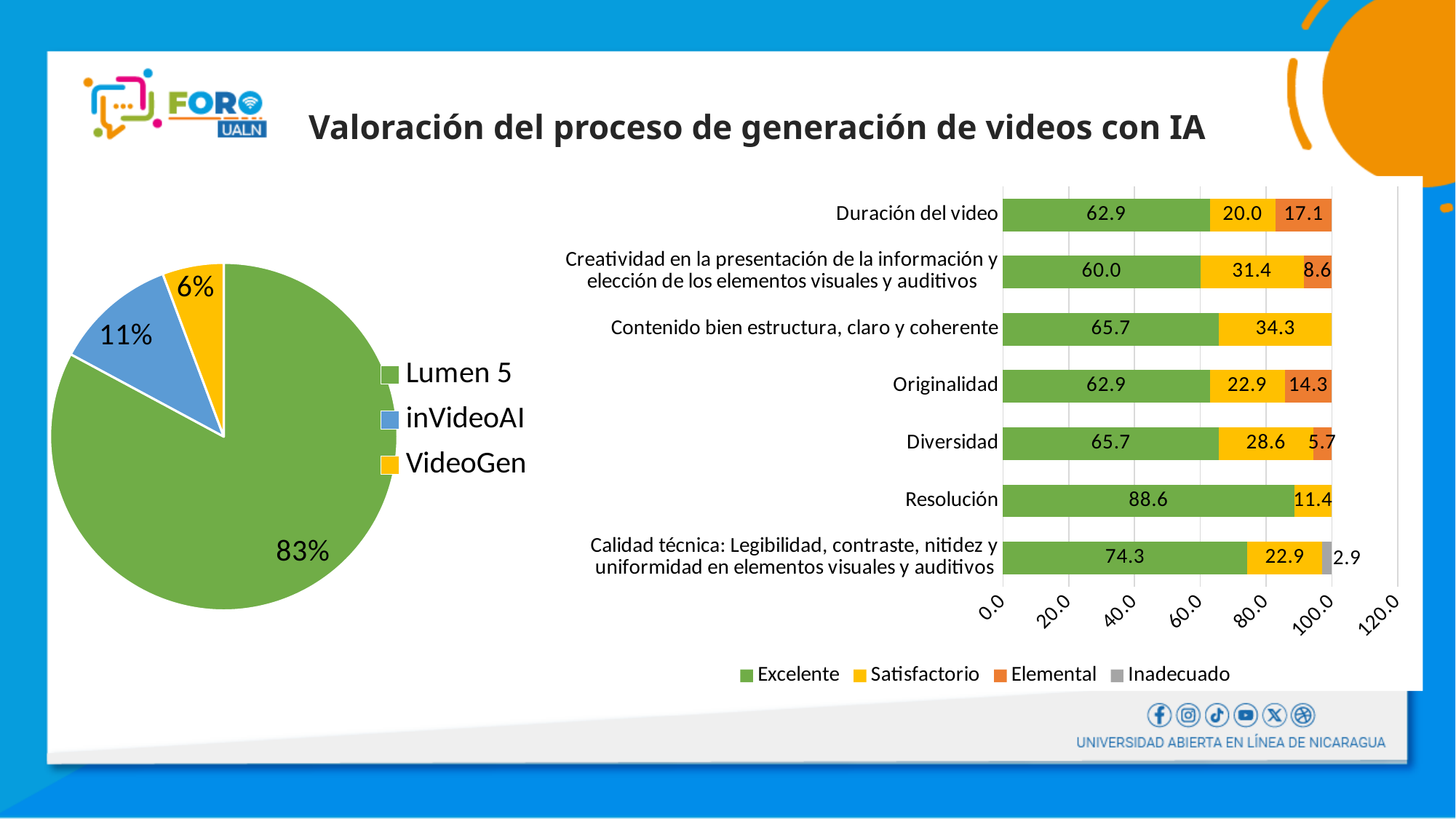
In the pie chart on the left, what share does Lumen 5 have? 83% In the stacked bar chart on the right, what is the Excelente value for Resolución? 88.6 In the pie chart on the left, how many slices are there? 3 In the stacked bar chart on the right, how many series does the legend list? 4 In the pie chart on the left, which tool has the smallest slice? VideoGen In the stacked bar chart on the right, which is larger: the Satisfactorio value for Diversidad or for Originalidad? Diversidad In the stacked bar chart on the right, which category has the highest Excelente value? Resolución In the stacked bar chart on the right, what is the difference between the Excelente values for Resolución and Originalidad? 25.7 In the stacked bar chart on the right, what is the Elemental value for Duración del video? 17.1 In the pie chart on the left, what share does VideoGen have? 6% In the stacked bar chart on the right, which category has an Inadecuado value of 2.9? Calidad técnica: Legibilidad, contraste, nitidez y uniformidad en elementos visuales y auditivos In the stacked bar chart on the right, what is the Satisfactorio value for Contenido bien estructura, claro y coherente? 34.3